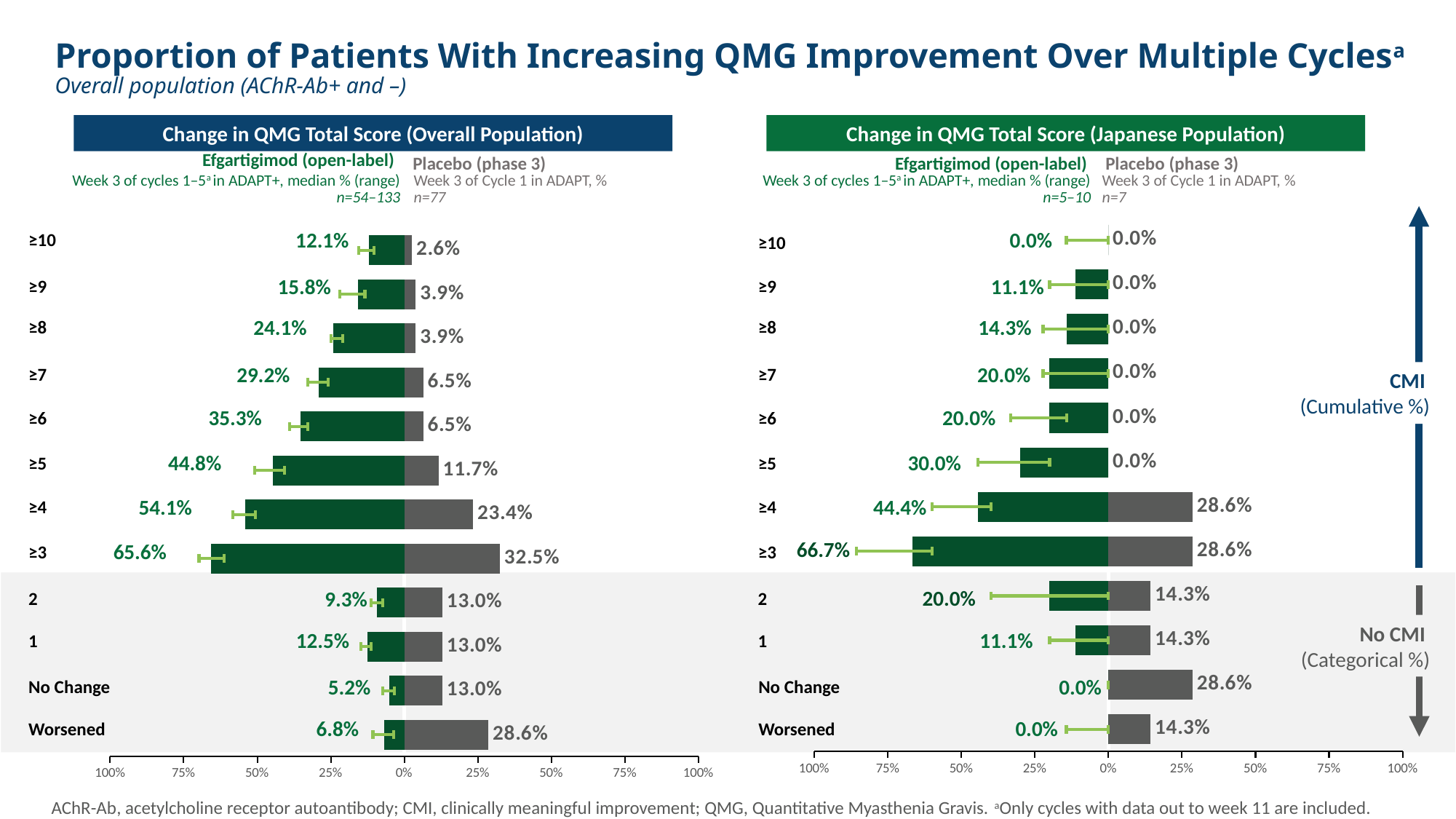
In the Change in QMG Total Score (Japanese Population) chart, how many categories are shown on the vertical axis? 12 In the Change in QMG Total Score (Japanese Population) chart, what is the difference between the Efgartigimod and Placebo values for the ≥3 category? 38.1% In the Change in QMG Total Score (Overall Population) chart, which category has the lowest Placebo value? ≥10 What kind of chart is the Change in QMG Total Score (Overall Population) chart? Bar chart In the Change in QMG Total Score (Overall Population) chart, which is larger for the Worsened category, the Efgartigimod value or the Placebo value? Placebo In the Change in QMG Total Score (Overall Population) chart, what is the sample size shown for the Placebo (phase 3) group? n=77 In the Change in QMG Total Score (Overall Population) chart, which category has the highest Efgartigimod value? ≥3 In the Change in QMG Total Score (Japanese Population) chart, what is the Placebo value for the No Change category? 28.6% In the Change in QMG Total Score (Overall Population) chart, what is the Efgartigimod value for the ≥3 category? 65.6% In the Change in QMG Total Score (Overall Population) chart, what is the Placebo value for the Worsened category? 28.6% In the Change in QMG Total Score (Japanese Population) chart, what is the Efgartigimod value for the ≥5 category? 30.0% In the Change in QMG Total Score (Overall Population) chart, what is the difference between the Efgartigimod and Placebo values for the ≥4 category? 30.7%